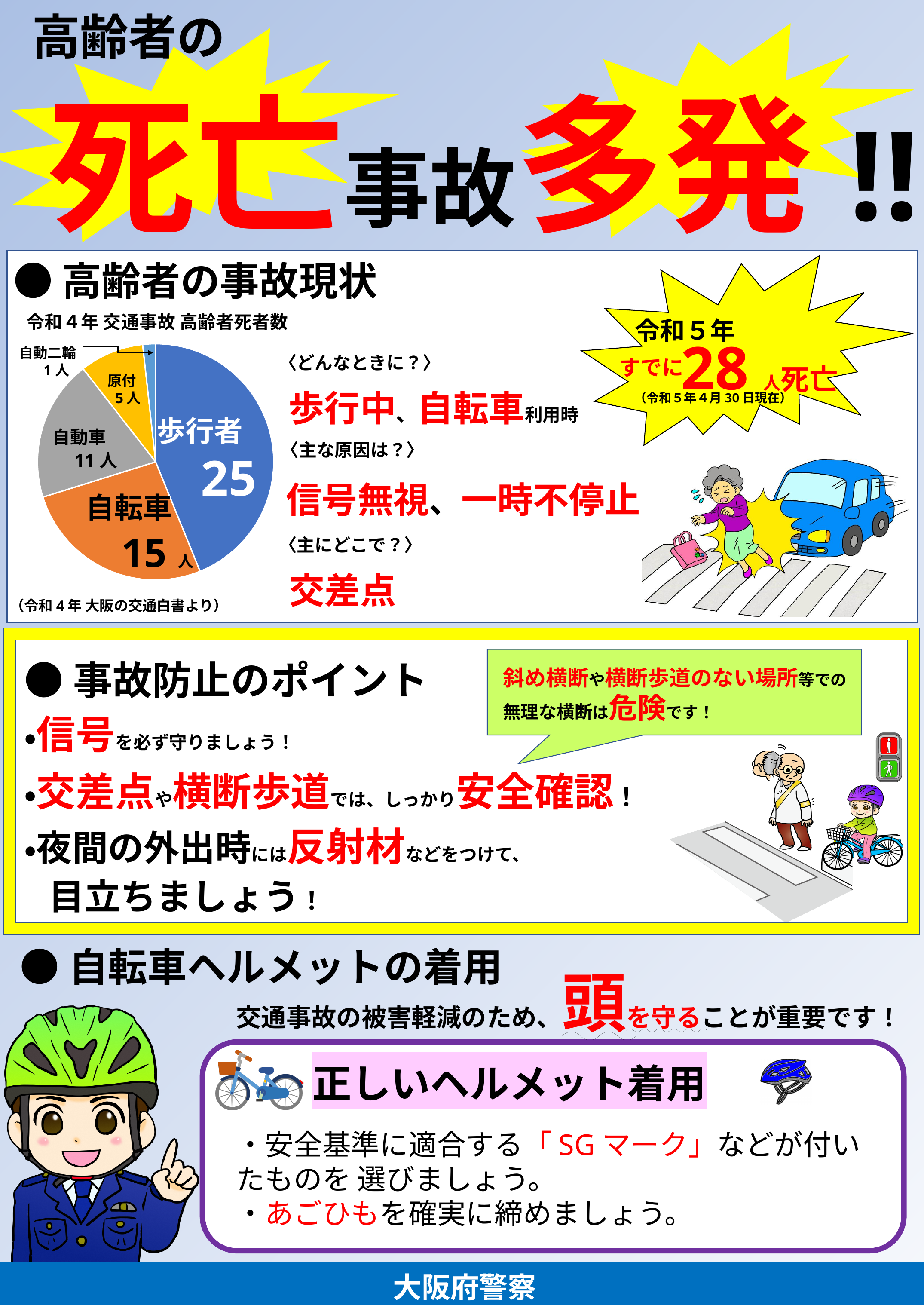
What is the title of the pie chart? 令和4年 交通事故 高齢者死者数 What kind of chart is shown on the slide? Pie chart What is the value for 原付 in the pie chart? 5人 How many categories does the pie chart have? 5 What is the value for 自転車 in the pie chart? 15人 What is the value for 自動車 in the pie chart? 11人 What is the value for 歩行者 in the pie chart? 25 What is the total of all the values in the pie chart? 57 Which is larger, the value for 自転車 or the value for 自動車? 自転車 What is the difference between the values for 歩行者 and 自転車? 10 Which category has the largest slice in the pie chart? 歩行者 Which category has the smallest slice in the pie chart? 自動二輪